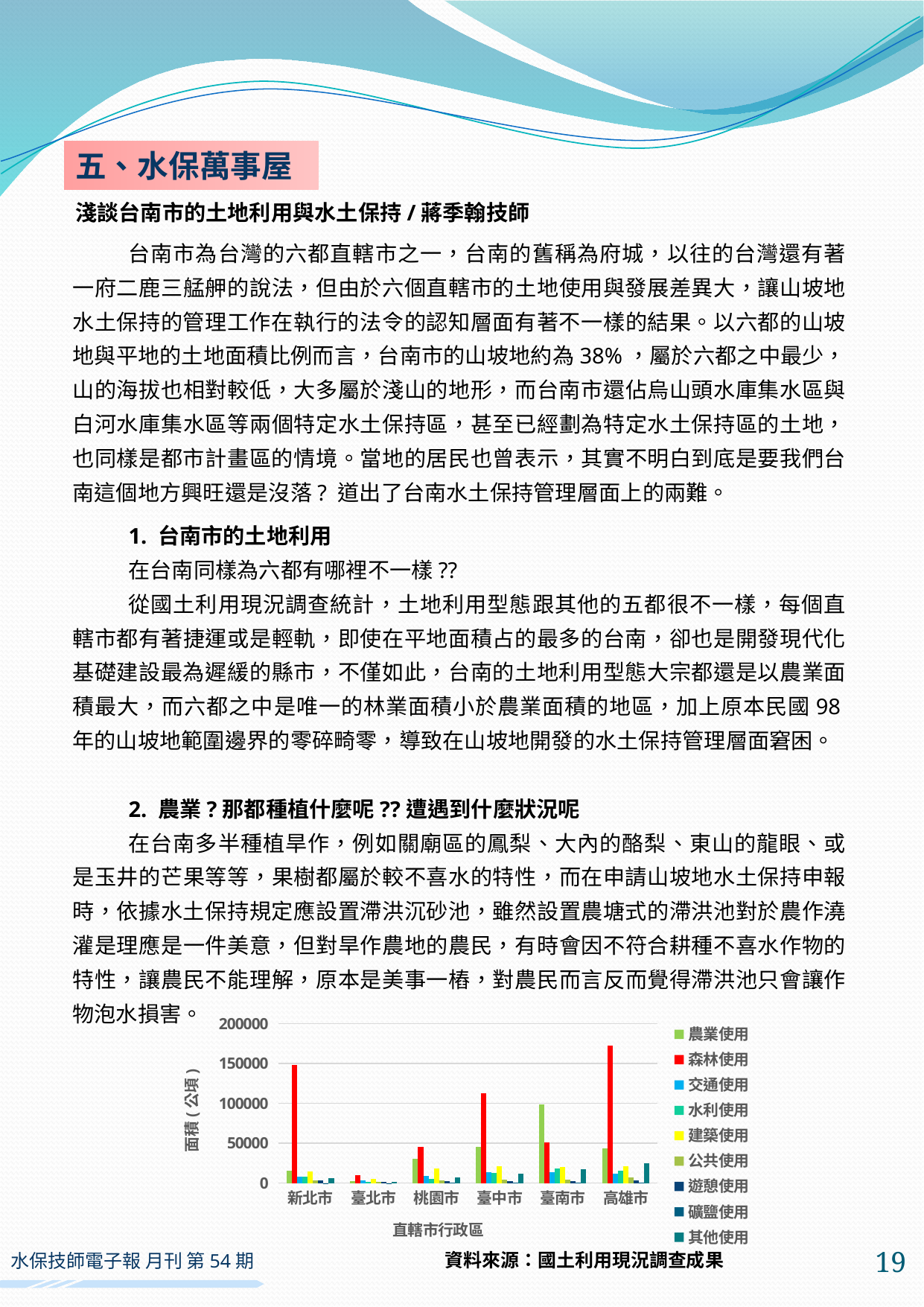
Is the value for 森林使用 in 新北市 greater or less than 100000? greater Which city has the highest value for 森林使用? 高雄市 Which city has the lowest value for 森林使用? 臺北市 What is the title of the chart's y axis? 面積(公頃) Is the value for 農業使用 in 臺南市 greater or less than 50000? greater How many cities (categories) are shown on the x axis of the chart? 6 What kind of chart is shown at the bottom of the slide? bar chart Which is larger: 森林使用 in 新北市 or 森林使用 in 高雄市? 高雄市 In 臺南市, which is larger: 農業使用 or 森林使用? 農業使用 How many series does the chart's legend list? 9 Which city has the highest value for 農業使用? 臺南市 Is the value for 森林使用 in 桃園市 greater or less than 50000? less